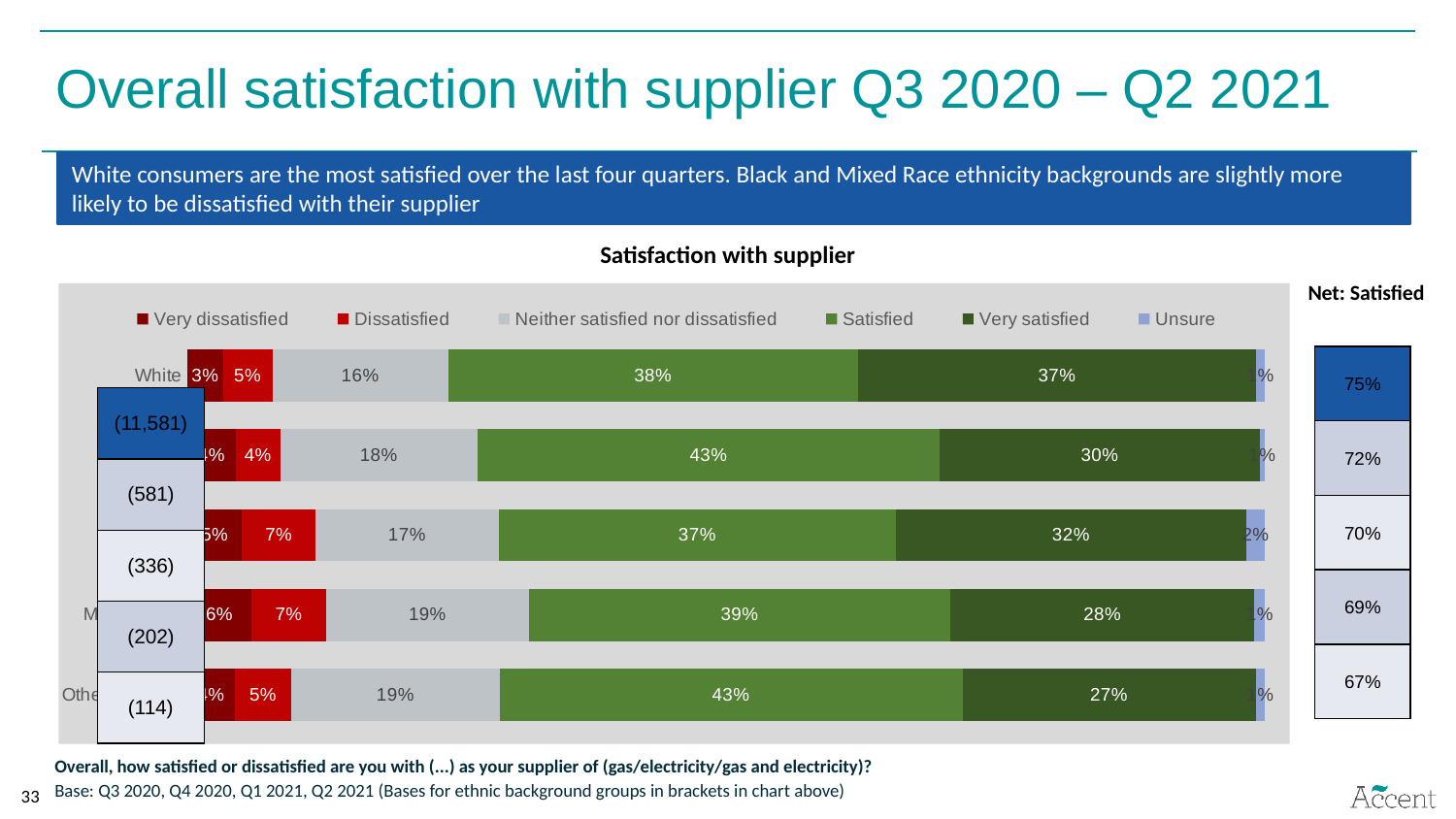
What is the difference between the 'Satisfied' and 'Very satisfied' percentages for White consumers? 1 percentage point For the group with base (202), what percentage are 'Satisfied'? 39% What percentage of White consumers are 'Neither satisfied nor dissatisfied'? 16% What is the title of the chart? Satisfaction with supplier Which group has the highest 'Net: Satisfied' value? White What percentage of White consumers are 'Satisfied' with their supplier? 38% How many ethnic background groups (bars) are shown in the chart? 5 Do the 'Net: Satisfied' values rise or fall going from the top bar to the bottom bar? Fall How many series does the legend of the 'Satisfaction with supplier' chart list? 6 What kind of chart is shown on the slide? Stacked bar chart What percentage of White consumers are 'Very satisfied' with their supplier? 37% What is the 'Net: Satisfied' value for White consumers? 75%